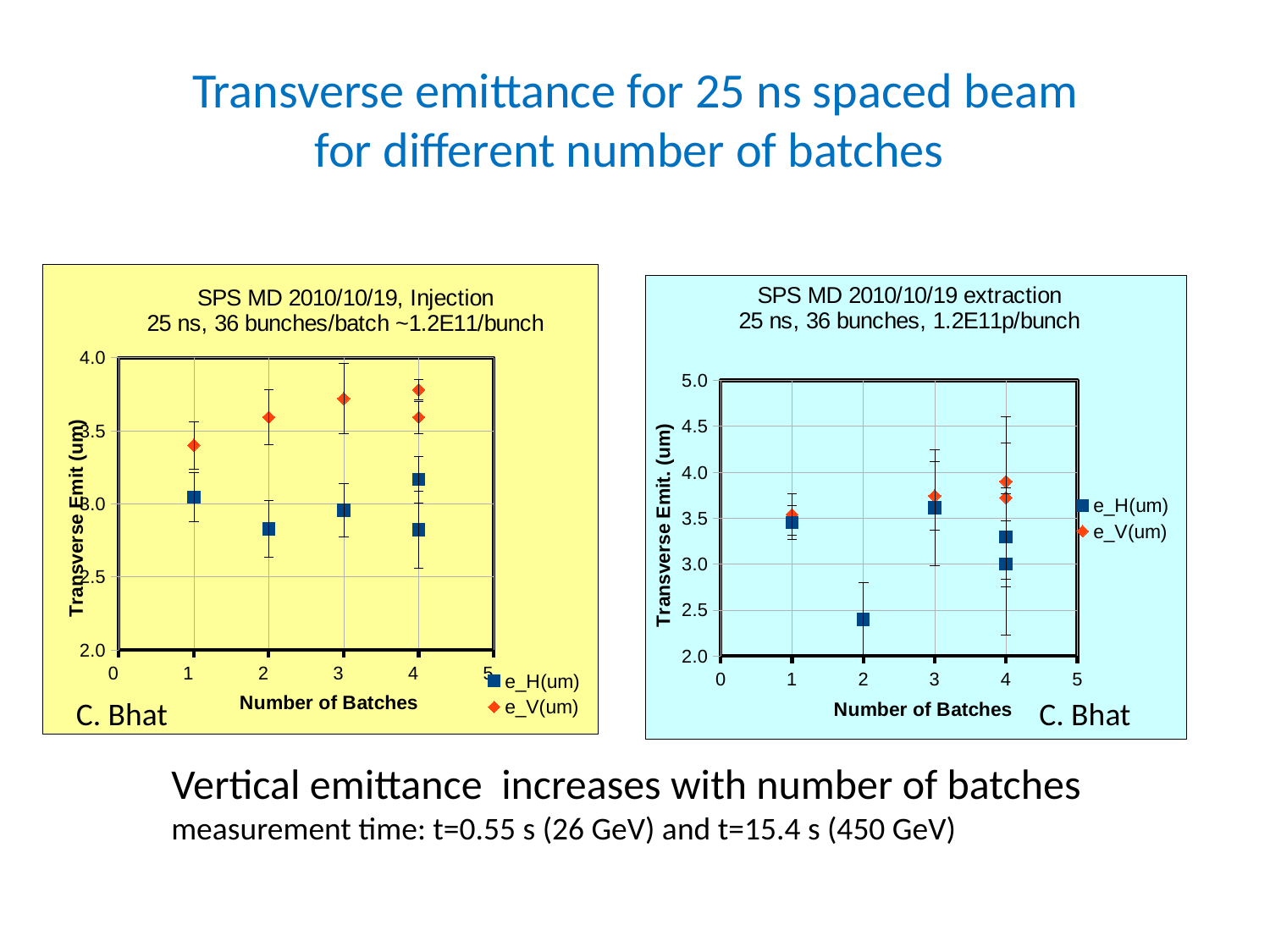
In the left chart (Injection), which series has the higher value at 3 batches, e_H(um) or e_V(um)? e_V(um) How many distinct numbers of batches have data points plotted in the left chart (Injection)? 4 In the right chart (extraction), is the e_V(um) value at 3 batches greater or less than 3.5? greater In the left chart (Injection), does the e_V(um) series rise or fall as the number of batches increases from 1 to 4? rise In the left chart (Injection), is the e_V(um) value at 1 batch greater or less than 3.0? greater What are the two legend entries in the left chart (Injection)? e_H(um) and e_V(um) What is the x-axis title of the right chart (extraction)? Number of Batches How many series does the legend of the right chart (SPS MD 2010/10/19 extraction) list? 2 In the right chart (extraction), is the e_H(um) value at 2 batches greater or less than 3.0? less In the right chart (extraction), which series has the lower value at 4 batches, e_H(um) or e_V(um)? e_H(um) What type of chart is the left chart titled 'SPS MD 2010/10/19, Injection'? scatter chart